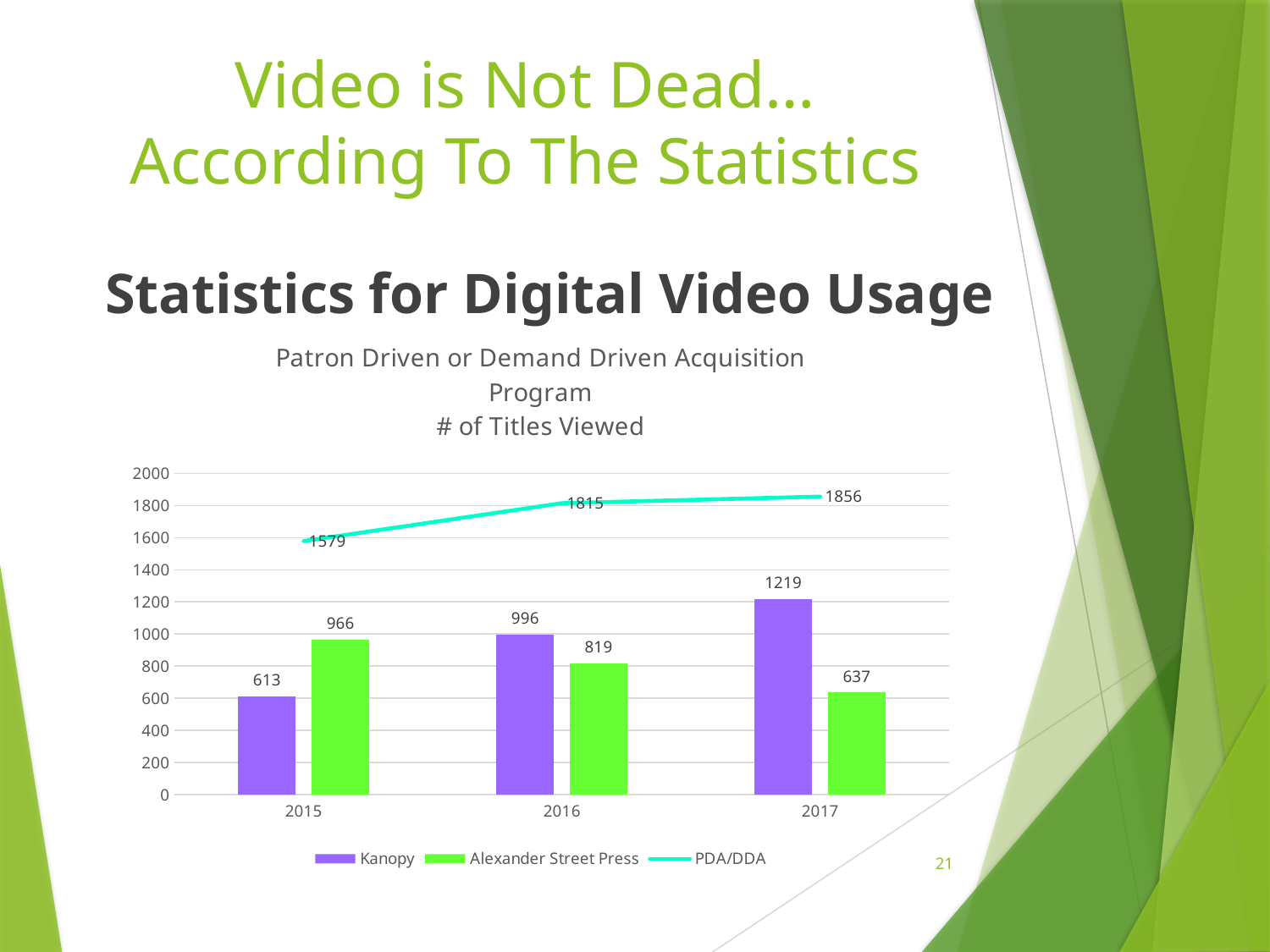
In which year is the Alexander Street Press value lowest? 2017 What is the difference between the Kanopy and Alexander Street Press values in 2017? 582 What is the value for Alexander Street Press in 2016? 819 Does the PDA/DDA line rise or fall from 2015 to 2017? rise What is the title of the chart? Patron Driven or Demand Driven Acquisition Program # of Titles Viewed What is the value for Kanopy in 2015? 613 In which year is the Kanopy value highest? 2017 Is the Kanopy value for 2016 greater or less than 800? greater Which is larger in 2015, Kanopy or Alexander Street Press? Alexander Street Press How many series does the legend list? 3 How many years are shown on the x axis? 3 What is the PDA/DDA value in 2017? 1856